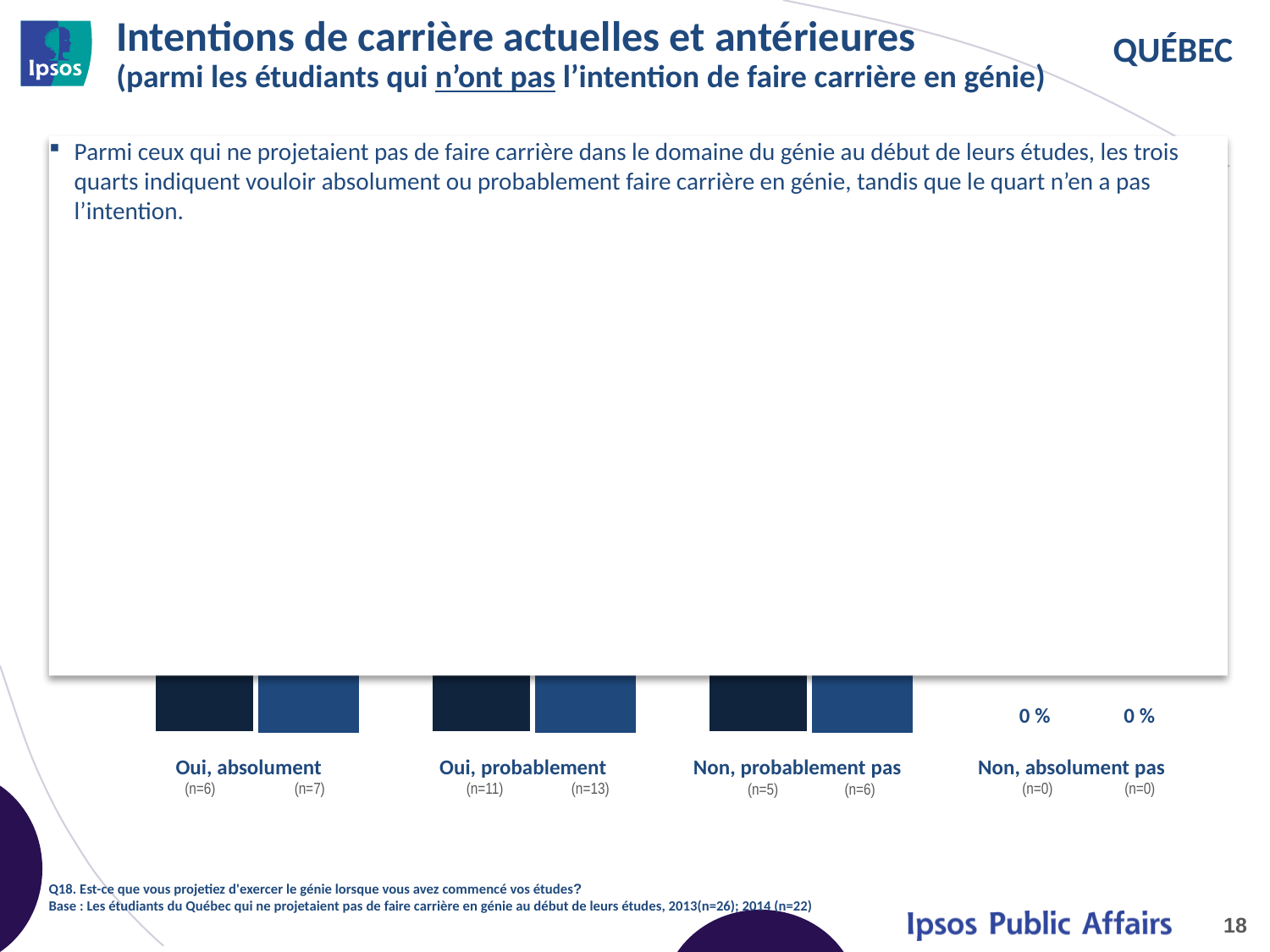
Which category has the lowest values in the chart? Non, absolument pas What is the label of the first category on the x axis? Oui, absolument How many bars are plotted for each category in the chart? 2 What kind of chart is shown on the slide? bar chart Is the value for "Oui, absolument" larger or smaller than the value for "Non, absolument pas"? larger How many categories are shown along the x axis of the chart? 4 What is the label of the third category on the x axis? Non, probablement pas What value is shown for the category "Non, absolument pas"? 0 %